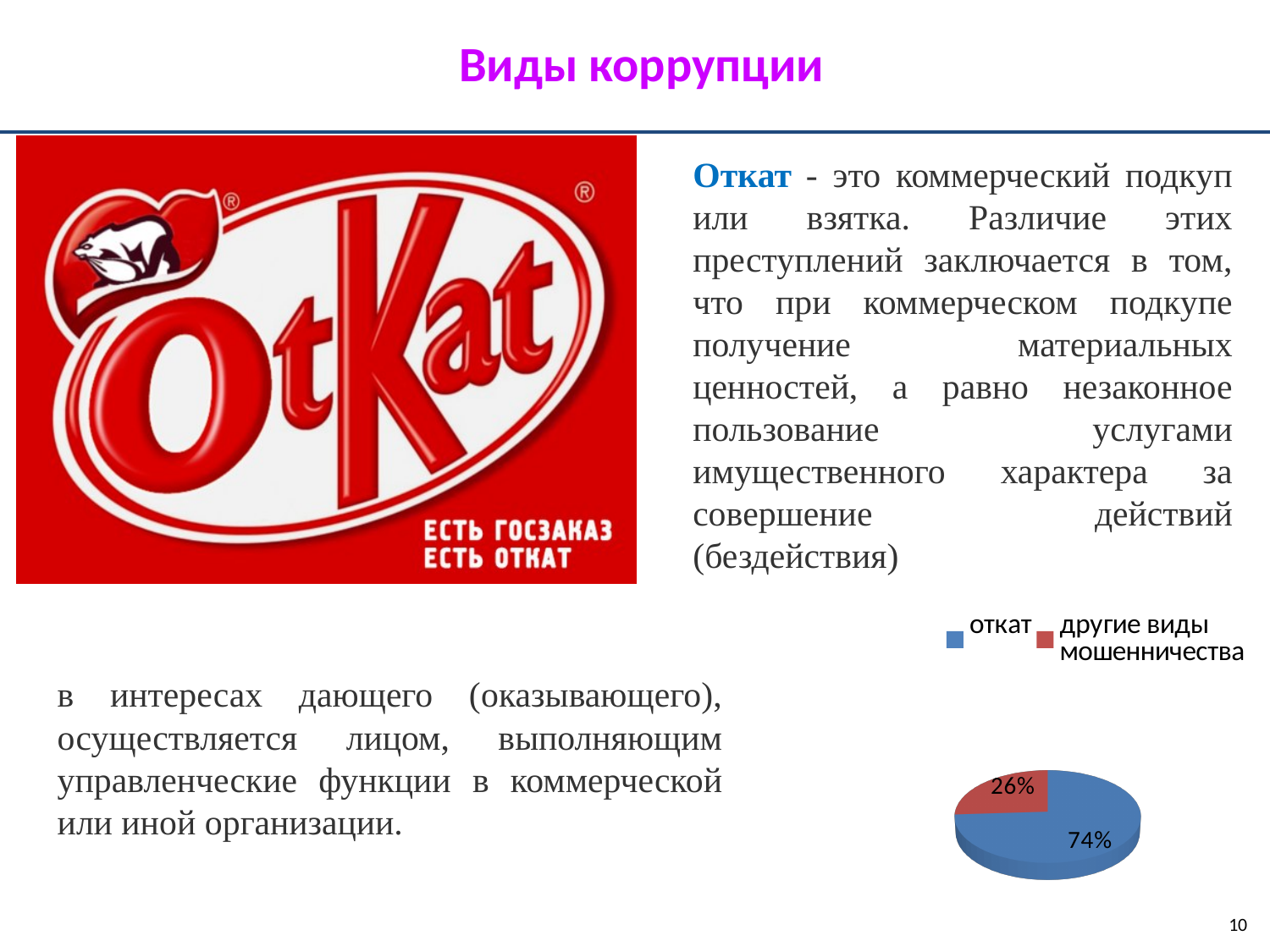
How many entries does the legend of the pie chart list? 2 What share of the pie does "откат" take? 74% Which slice of the pie is the largest? откат Which is larger: the share for "откат" or the share for "другие виды мошенничества"? откат What kind of chart is shown on the slide? pie chart What is the difference in percentage points between the "откат" slice and the "другие виды мошенничества" slice? 48 Which slice of the pie is the smallest? другие виды мошенничества How many slices does the pie chart have? 2 What is the total of the two slices shown in the pie chart? 100% What colour is the "откат" slice in the pie chart? blue What share of the pie does "другие виды мошенничества" take? 26% What colour is the "другие виды мошенничества" slice in the pie chart? red